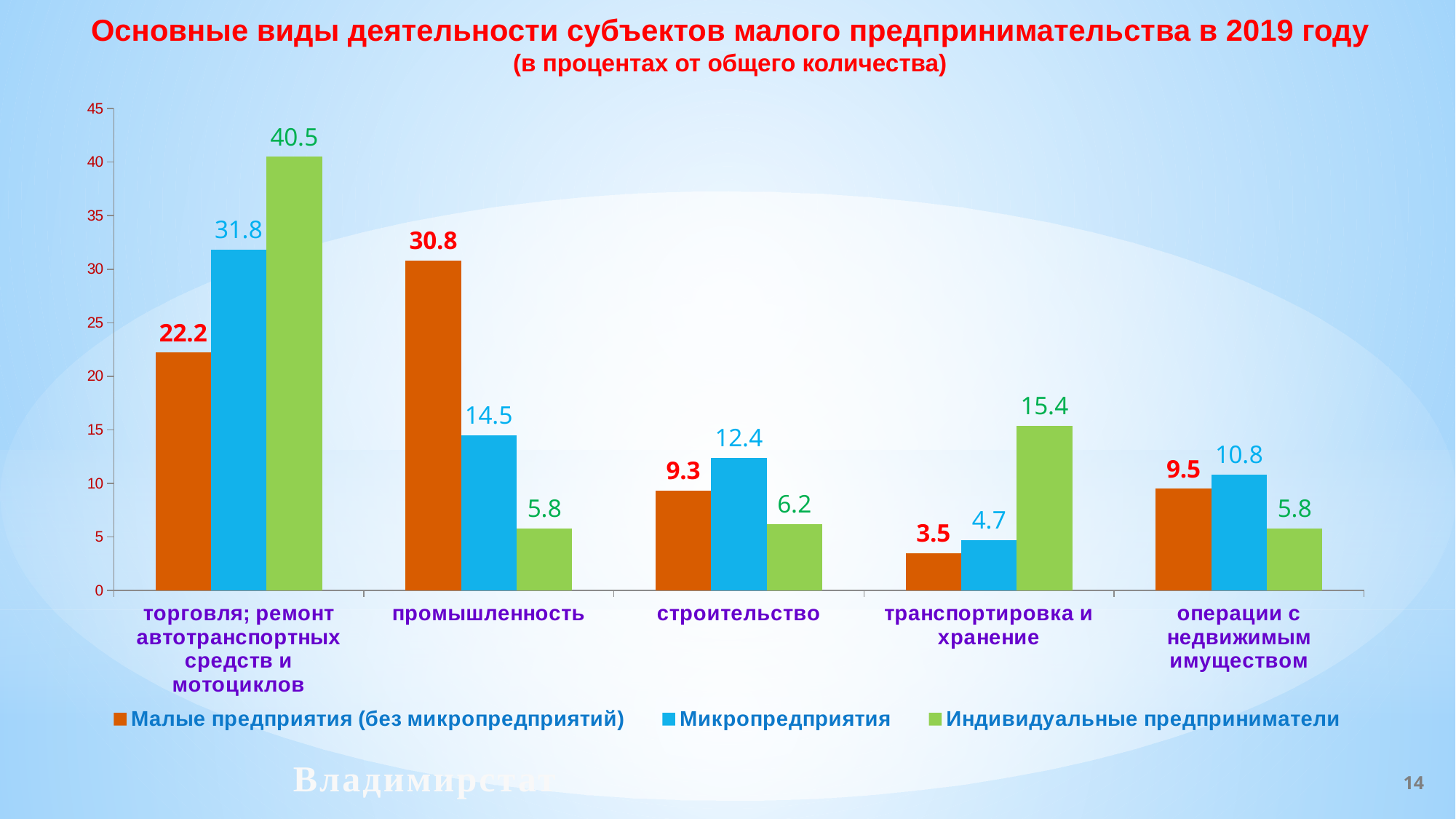
What is the value for Малые предприятия (без микропредприятий) in the category промышленность? 30.8 Is the value for Индивидуальные предприниматели in the category транспортировка и хранение greater or less than 10? greater In the category операции с недвижимым имуществом, which is larger: Микропредприятия or Индивидуальные предприниматели? Микропредприятия What colour are the bars for Микропредприятия? blue What is the value for Индивидуальные предприниматели in the category торговля; ремонт автотранспортных средств и мотоциклов? 40.5 How many categories are shown on the x axis? 5 What is the difference between the Индивидуальные предприниматели value and the Малые предприятия (без микропредприятий) value in the category торговля; ремонт автотранспортных средств и мотоциклов? 18.3 Which category has the highest value for Малые предприятия (без микропредприятий)? промышленность What kind of chart is shown on the slide? bar chart How many series does the legend list? 3 What is the value for Микропредприятия in the category строительство? 12.4 Which category has the lowest value for Микропредприятия? транспортировка и хранение